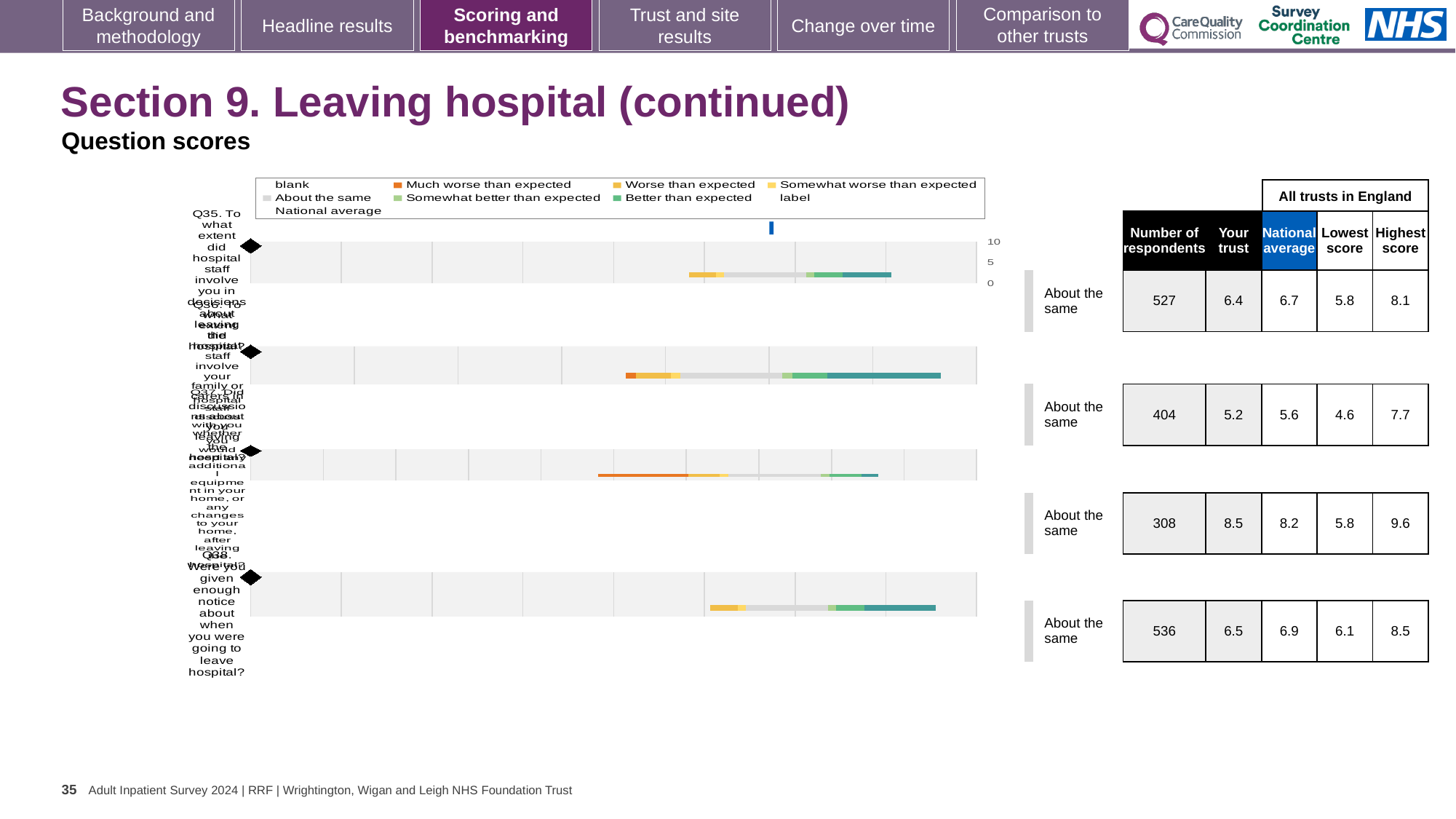
What kind of chart is used to show the question scores on this slide? bar chart How many question score charts (rows) are shown on the slide? 4 In the table beside the charts, what is the national average for the first row (Q35)? 6.7 In the table beside the charts, what is the highest score for the third row? 9.6 What benchmark category is shown next to every one of the four question charts? About the same What is the title of the slide containing these charts? Section 9. Leaving hospital (continued) In the table beside the charts, what is the difference between the highest score and the lowest score for the last row (Q38)? 2.4 In the table beside the charts, how many respondents are listed for the last row (Q38)? 536 In the table beside the charts, which row has the lowest number of respondents? the third row (308) In the table beside the charts, is the 'Your trust' score for the second row larger or smaller than its national average? smaller In the table beside the charts, which row has the highest 'Your trust' score? the third row (8.5) In the table beside the charts, what is the 'Your trust' score for the first row (Q35)? 6.4